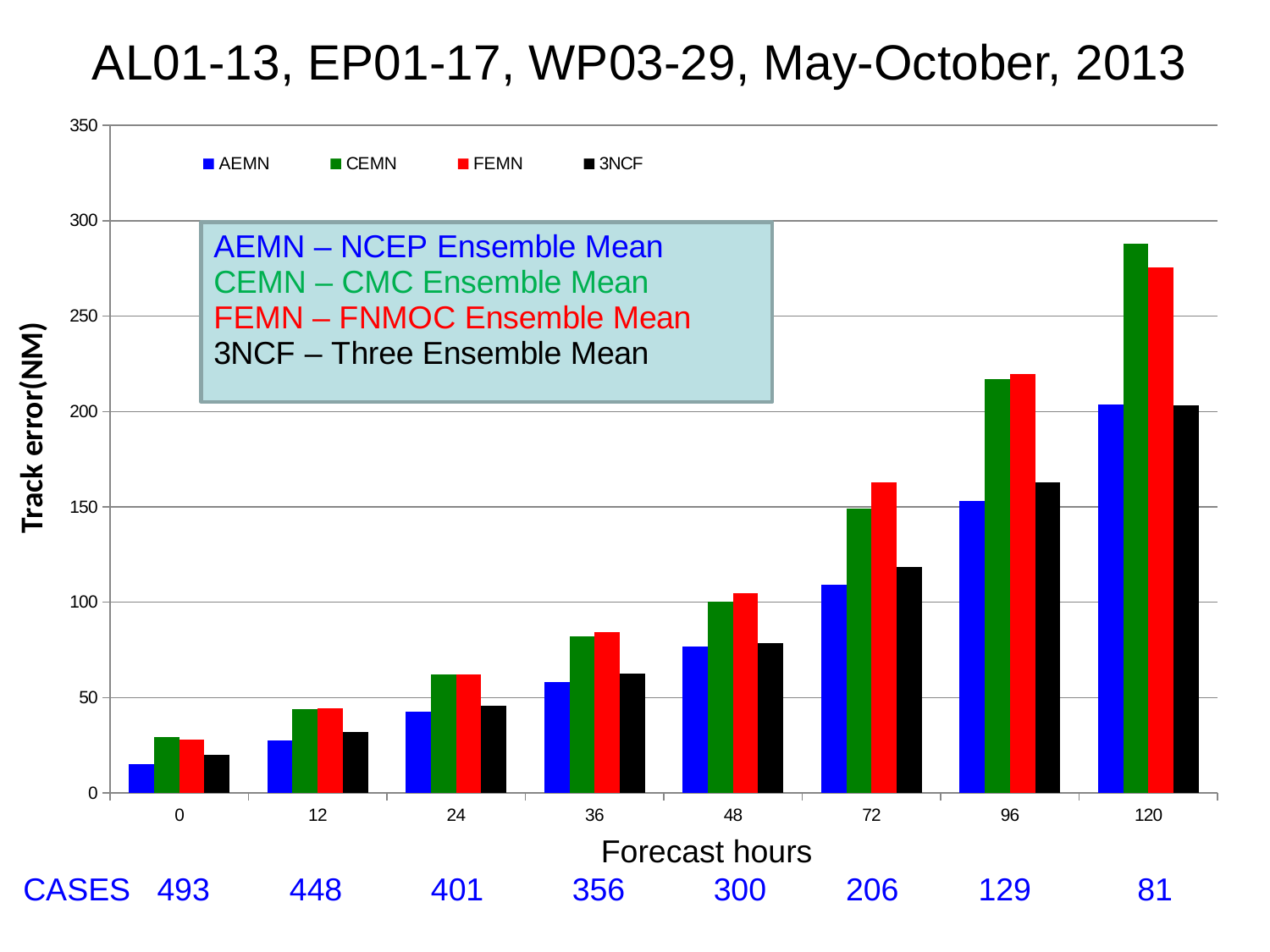
How many series does the legend list? 4 Does the AEMN track error rise or fall as forecast hours increase? rise Is the 3NCF track error at 48 forecast hours greater or less than 100? less At 120 forecast hours, which series has the highest track error? CEMN At 72 forecast hours, which series has the lowest track error? AEMN Is the FEMN track error at 72 forecast hours greater or less than 150? greater At 72 forecast hours, which has the larger track error, CEMN or FEMN? FEMN According to the legend box, what does CEMN stand for? CMC Ensemble Mean What kind of chart is shown on the slide? bar chart How many forecast-hour categories are shown on the x axis? 8 Is the AEMN track error at 120 forecast hours greater or less than 250? less What is the title of the y axis? Track error(NM)